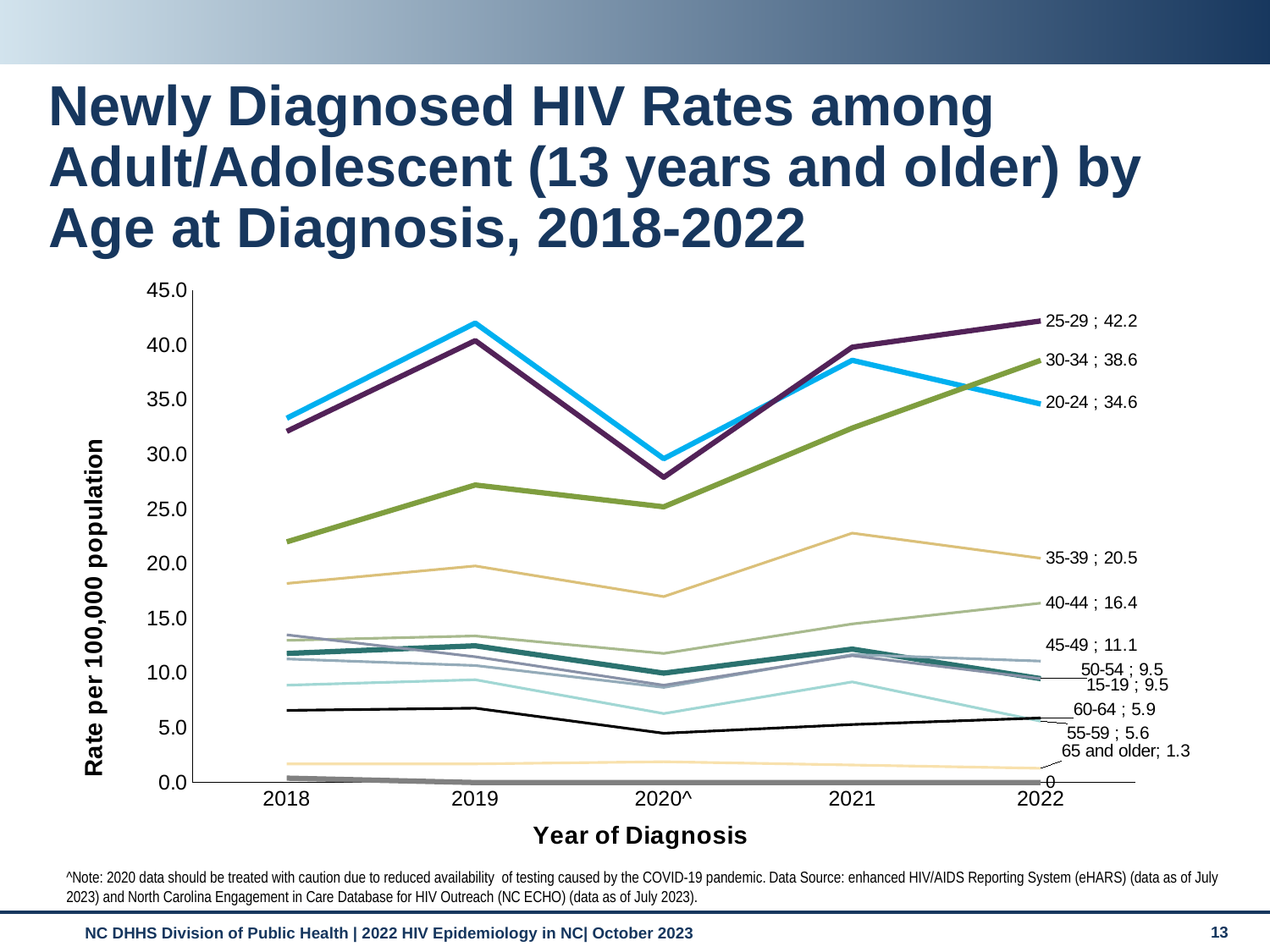
What is the difference between the 2022 rates for the 25-29 and 20-24 age groups? 7.6 What kind of chart is shown on the slide? Line chart Is the 2020 value for the 35-39 age group greater or less than 20.0? less How many years of diagnosis are shown on the x axis? 5 What is the 2022 rate for the 25-29 age group? 42.2 In 2022, which age group has the larger rate, 40-44 or 45-49? 40-44 What is the 2022 rate for the 65 and older age group? 1.3 Is the 2019 value for the 20-24 age group greater or less than 40.0? greater What is the 2022 rate for the 35-39 age group? 20.5 What is the label of the y axis? Rate per 100,000 population What is the 2022 rate for the 30-34 age group? 38.6 Which age group has the highest rate in 2022? 25-29